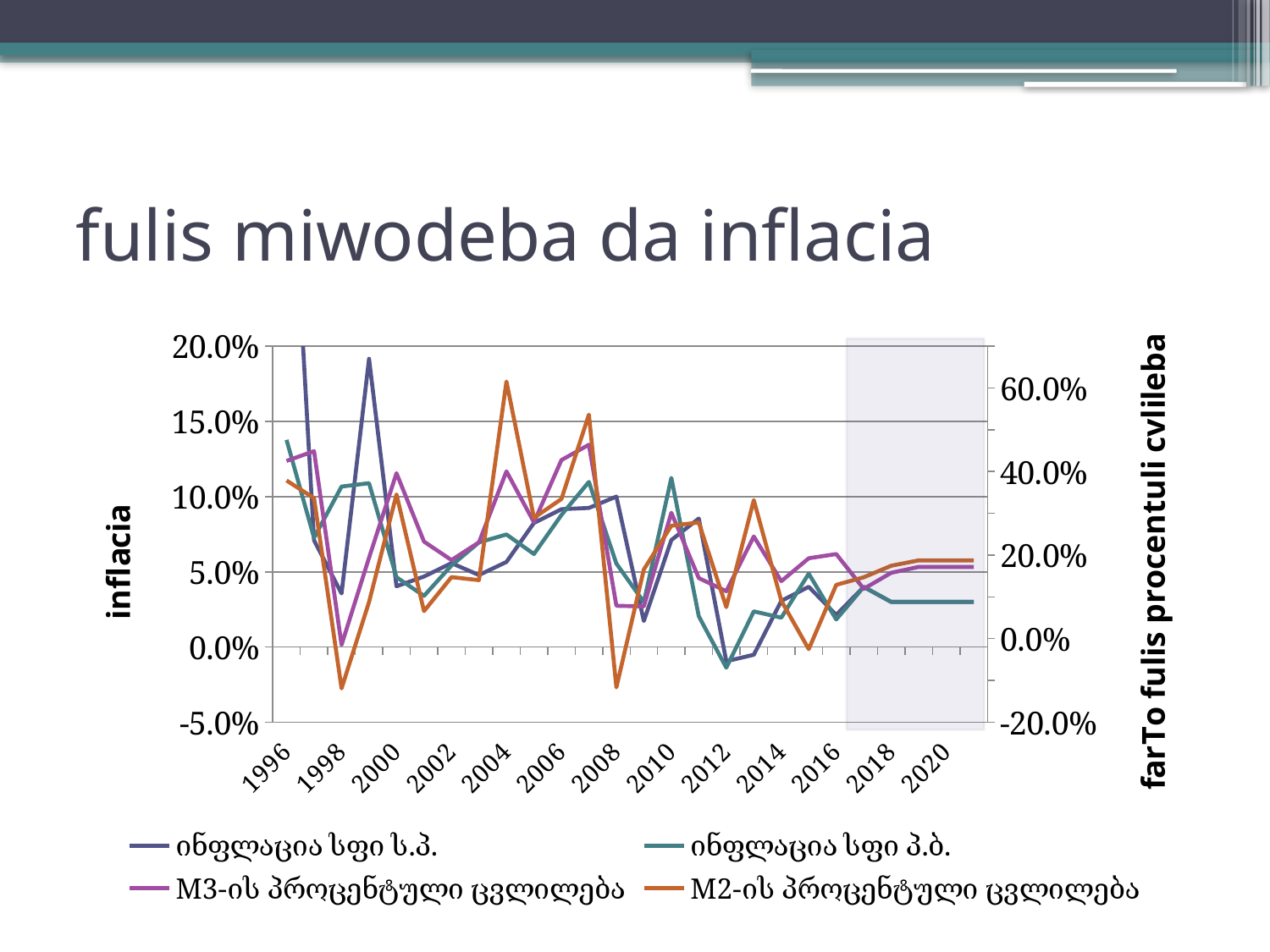
Is the value of the M2-ის პროცენტული ცვლილება line in 1998 greater or less than 0.0% on the right axis? less Is the value of the ინფლაცია სფი ს.პ. line in 1999 greater or less than 15.0% on the left axis? greater In 1999, which line is higher on the left axis: ინფლაცია სფი ს.პ. or ინფლაცია სფი პ.ბ.? ინფლაცია სფი ს.პ. How many series does the legend list? 4 Is the value of the ინფლაცია სფი ს.პ. line in 2020 greater or less than 10.0% on the left axis? less What is the label of the left vertical axis? inflacia What kind of chart is shown on the slide? line chart How many year labels are shown along the x axis? 13 Does the ინფლაცია სფი ს.პ. line overall rise or fall from 1996 to 2020? fall